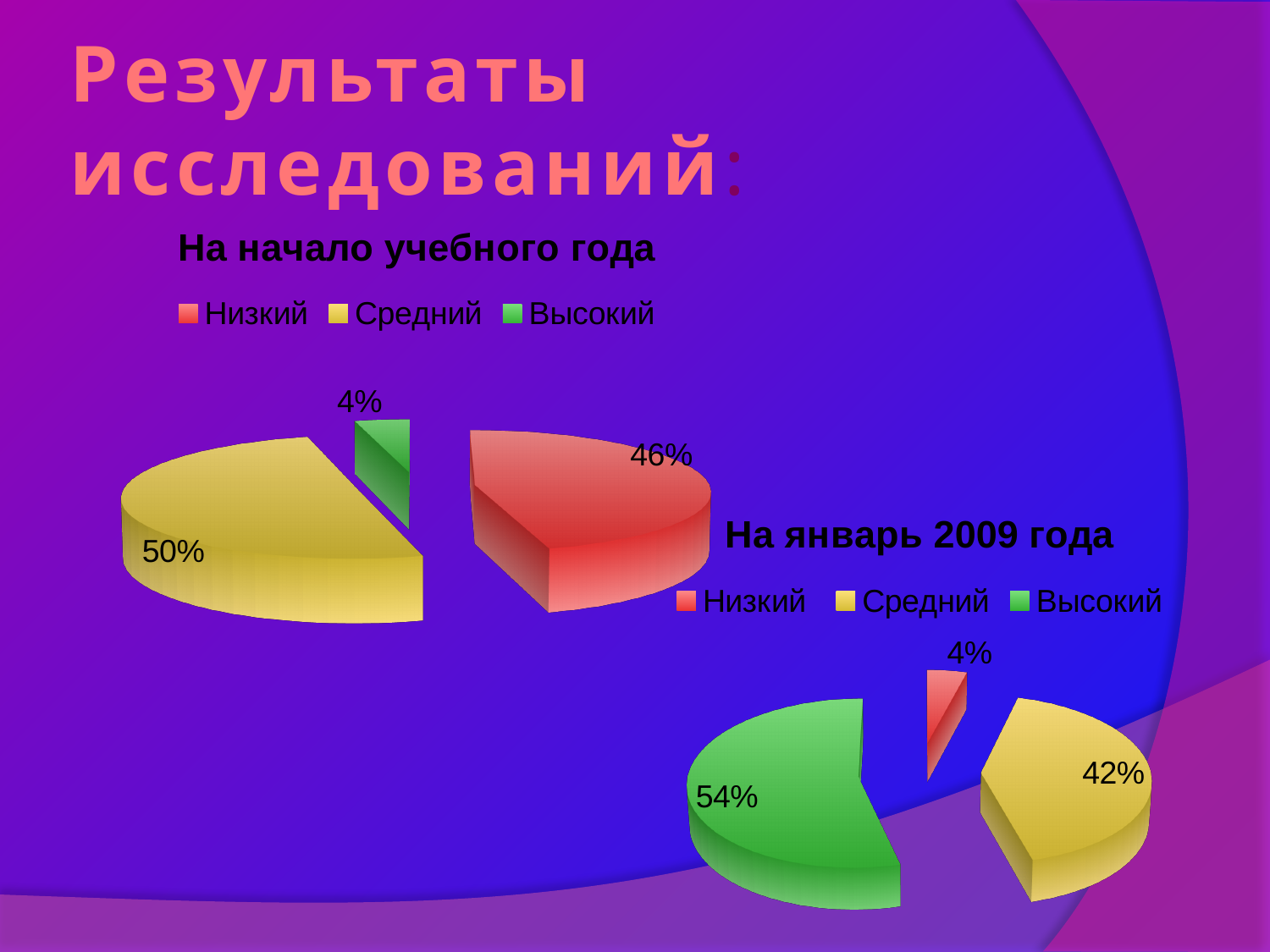
In the chart 'На январь 2009 года', what share is labelled for Средний? 42% In the chart 'На начало учебного года', what share is labelled for Средний? 50% In the chart 'На начало учебного года', what share is labelled for Низкий? 46% In the chart 'На январь 2009 года', which category has the smallest share? Низкий In the chart 'На январь 2009 года', what share is labelled for Высокий? 54% In the chart 'На январь 2009 года', what is the difference between the shares of Высокий and Средний? 12% In the chart 'На начало учебного года', which is larger, the share of Низкий or the share of Высокий? Низкий How many categories does the legend of the chart 'На начало учебного года' list? 3 What kind of chart is 'На январь 2009 года'? Pie chart In the chart 'На начало учебного года', what share is labelled for Высокий? 4% In the chart 'На начало учебного года', which category has the largest share? Средний In the chart 'На январь 2009 года', what share is labelled for Низкий? 4%